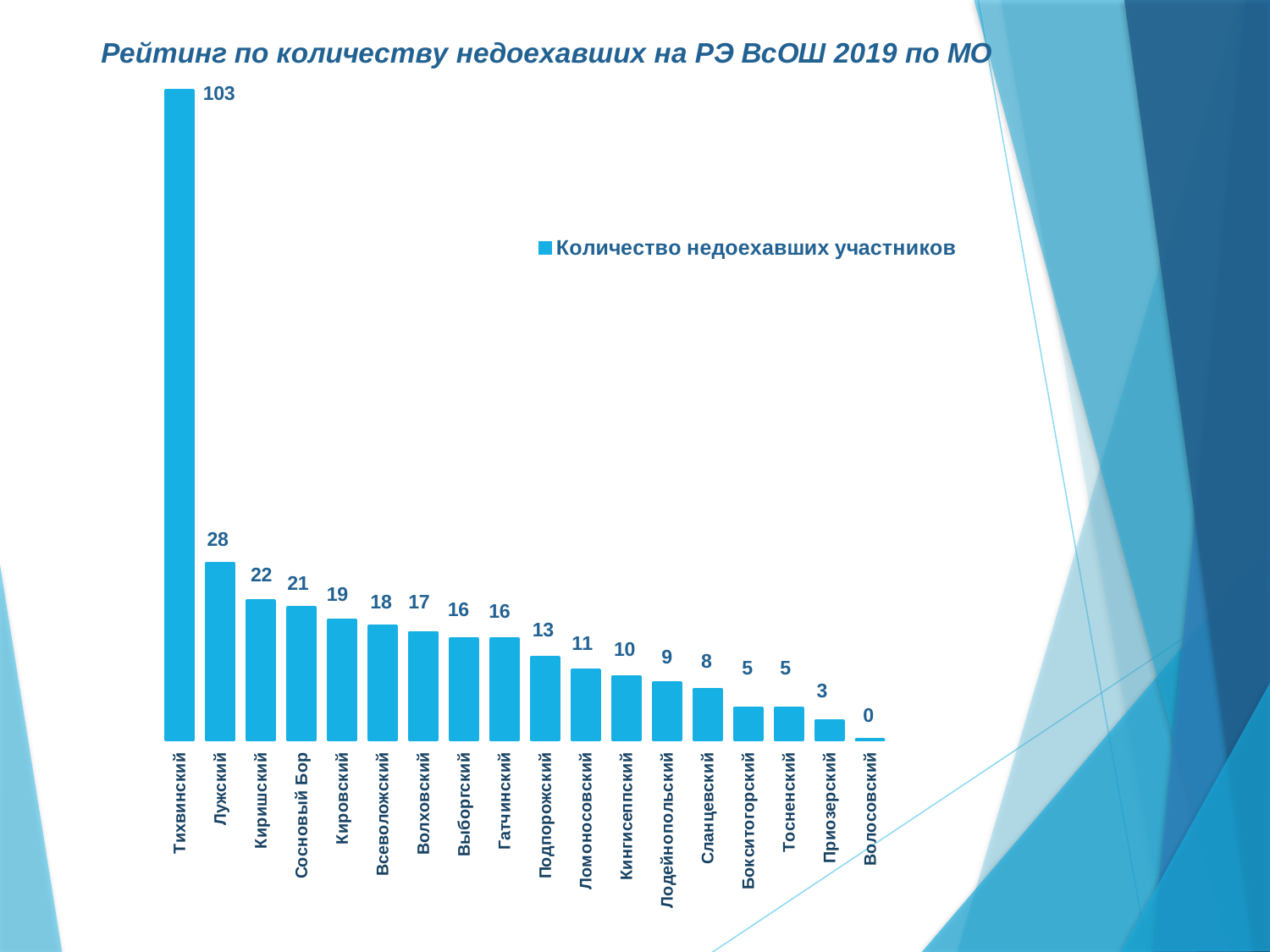
How many series does the legend list? 1 What is the difference between the values for Тихвинский and Лужский? 75 How many categories are shown on the x axis? 18 What is the value for Лужский? 28 What is the value for Подпорожский? 13 Which category has the highest value? Тихвинский Do the values rise or fall from left to right along the x axis? fall Which is larger, the value for Киришский or the value for Кировский? Киришский What kind of chart is shown on the slide? bar chart Which category has the lowest value? Волосовский What is the legend entry for the series? Количество недоехавших участников What is the value for Тихвинский? 103